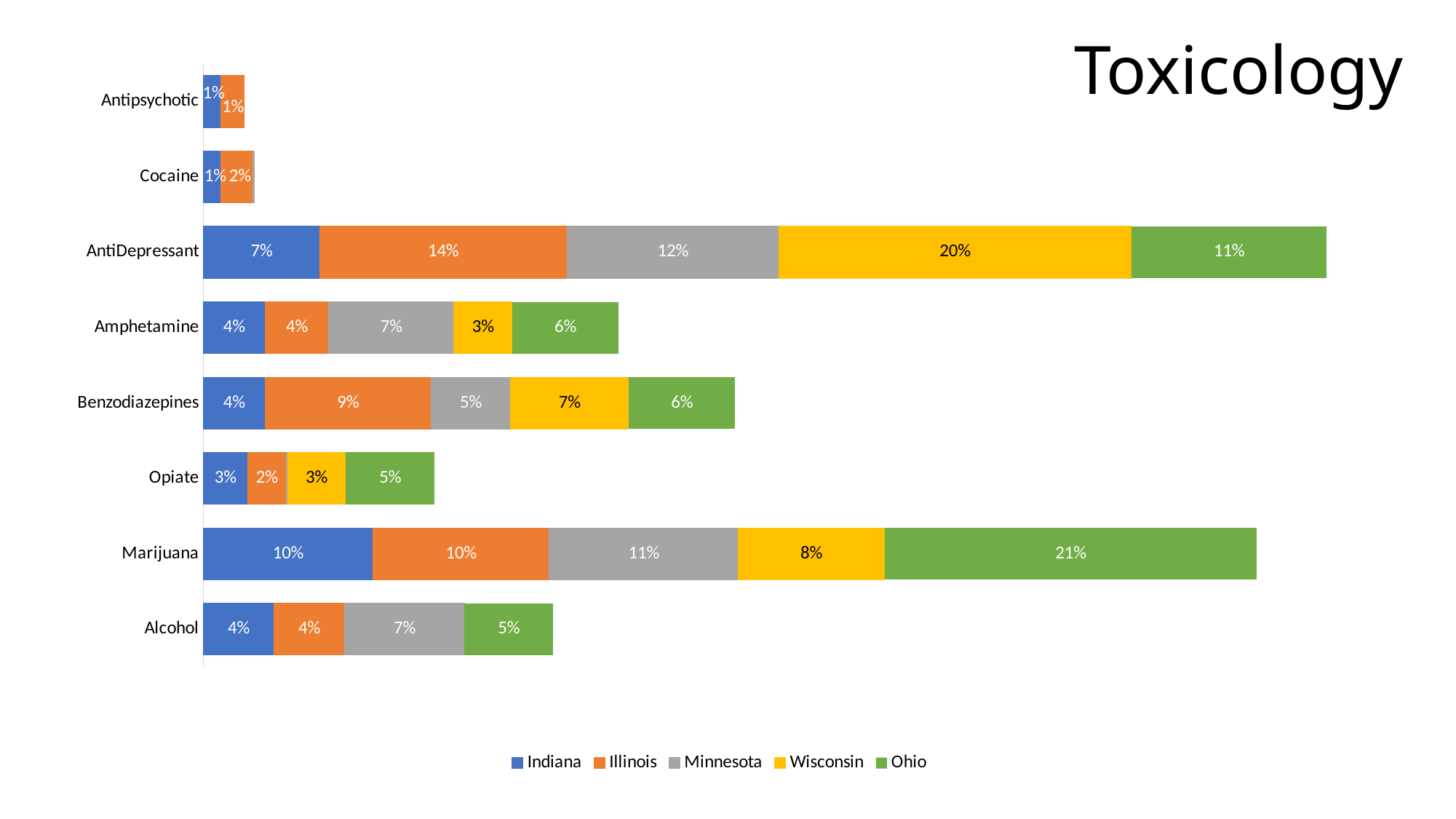
What is the Wisconsin value for AntiDepressant? 20% What is the Minnesota value for Benzodiazepines? 5% Which state has the highest value for AntiDepressant? Wisconsin What type of chart is shown on the slide? Stacked bar chart What is the Ohio value for Marijuana? 21% What is the total of the stacked bar for Alcohol? 20% What is the total of the stacked bar for Amphetamine? 24% Which is larger, the Ohio value for Marijuana or the Ohio value for AntiDepressant? Ohio value for Marijuana How many series does the legend list? 5 What is the title of the chart? Toxicology What is the difference between the Illinois and Indiana values for Benzodiazepines? 5% How many substance categories are shown on the chart? 8